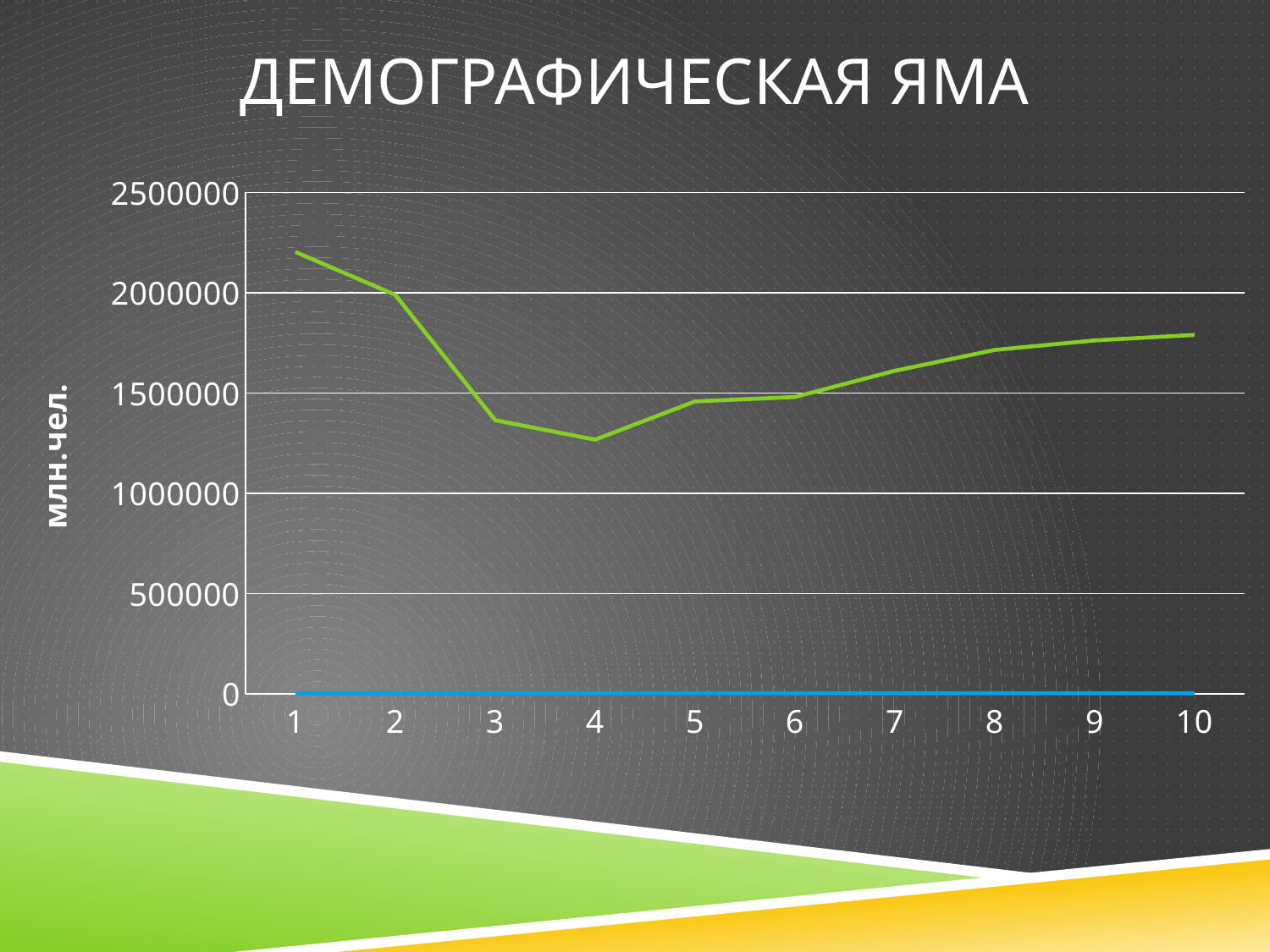
Is the value of the green line at point 4 greater or less than 1500000? less How many points are plotted along the x axis of the chart? 10 Is the value of the green line at point 10 greater or less than 1500000? greater What is the title of the chart? ДЕМОГРАФИЧЕСКАЯ ЯМА At which x-axis point does the green line reach its lowest value? 4 Is the value of the green line at point 1 greater or less than 2000000? greater What kind of chart is shown on the slide? line chart Does the green line rise or fall from point 4 to point 10? rise What is the label on the vertical axis of the chart? млн.чел. At which x-axis point does the green line reach its highest value? 1 Which is larger: the green line's value at point 1 or at point 10? point 1